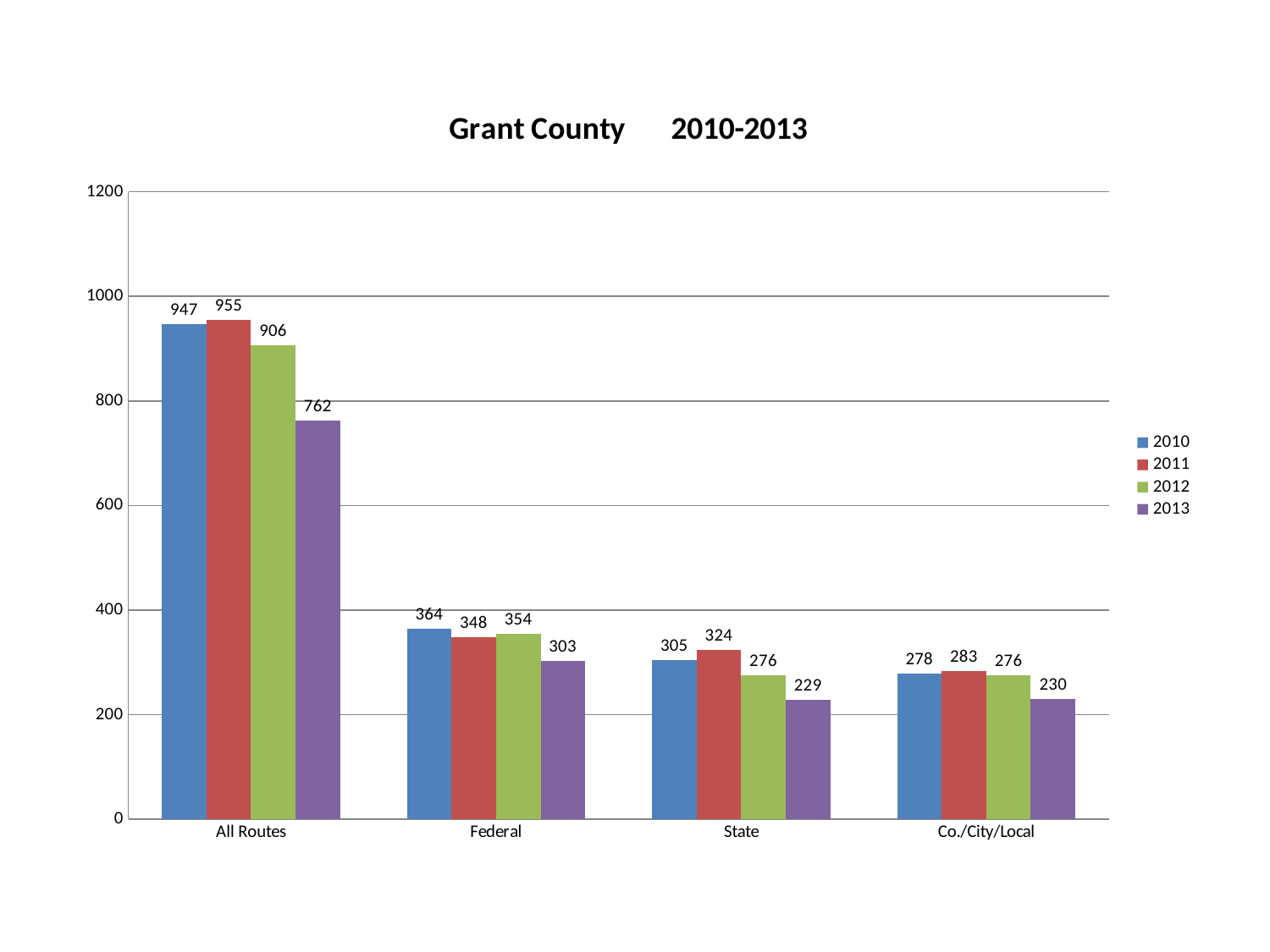
What is the value for Co./City/Local in 2012? 276 Which is larger, the 2012 value for Federal or the 2012 value for State? Federal How many categories are shown on the x axis? 4 What is the title of the chart? Grant County 2010-2013 What kind of chart is this? Bar chart What is the value for Federal in 2010? 364 What is the value for State in 2011? 324 Which year has the highest value for All Routes? 2011 What is the value for All Routes in 2013? 762 What is the difference between the 2010 and 2013 values for All Routes? 185 How many series does the legend list? 4 Which year has the lowest value for State? 2013